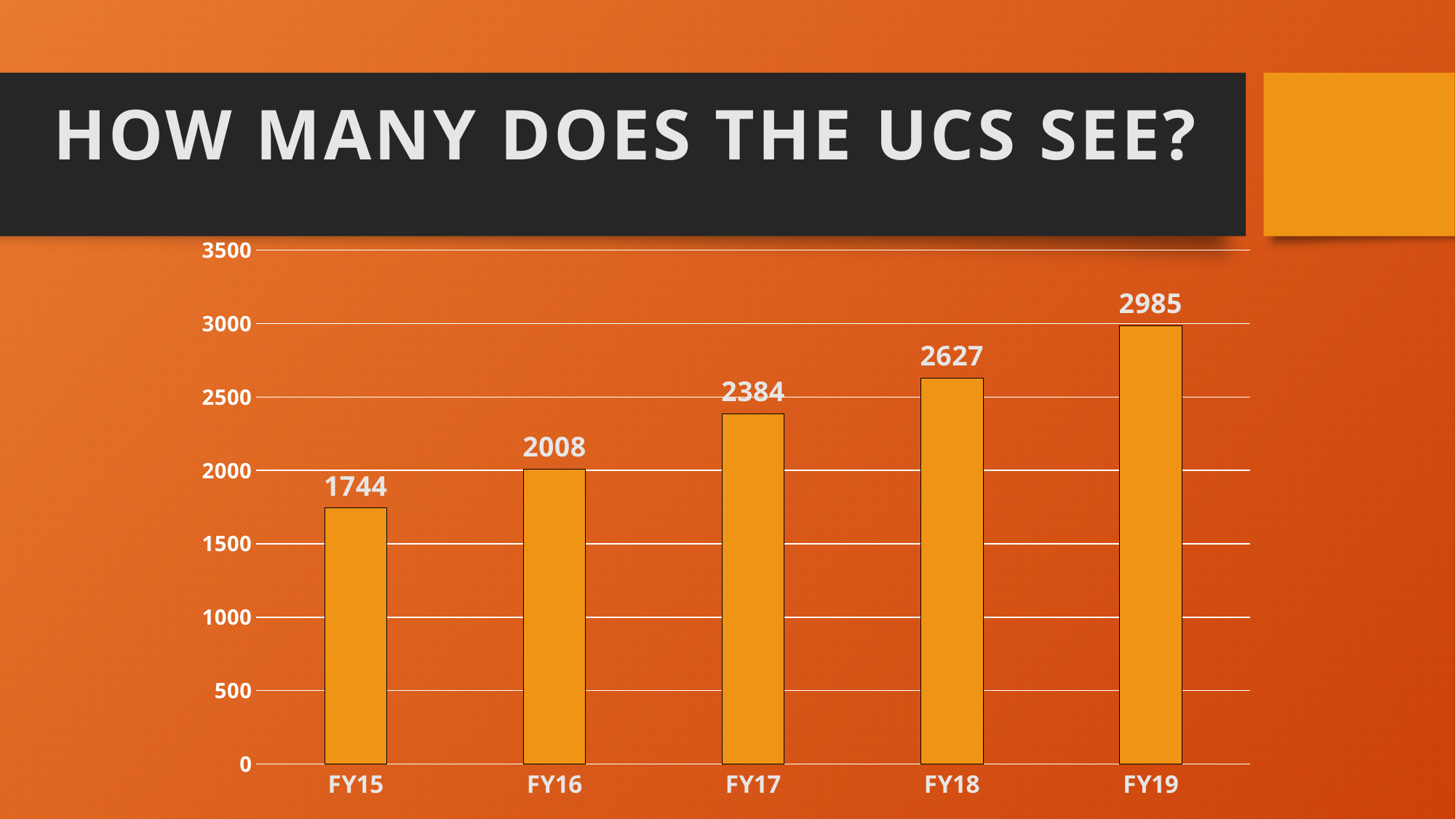
Which is larger, the value for FY16 or the value for FY18? FY18 What is the difference between the values for FY18 and FY17? 243 How many fiscal years are shown on the chart? 5 Which fiscal year has the lowest value? FY15 Is the value for FY16 greater or less than 2500? less What is the difference between the values for FY19 and FY15? 1241 What is the value for FY19? 2985 What is the value for FY17? 2384 Do the values rise or fall from FY15 to FY19? rise What is the value for FY15? 1744 What kind of chart is shown on the slide? bar chart Which fiscal year has the highest value? FY19